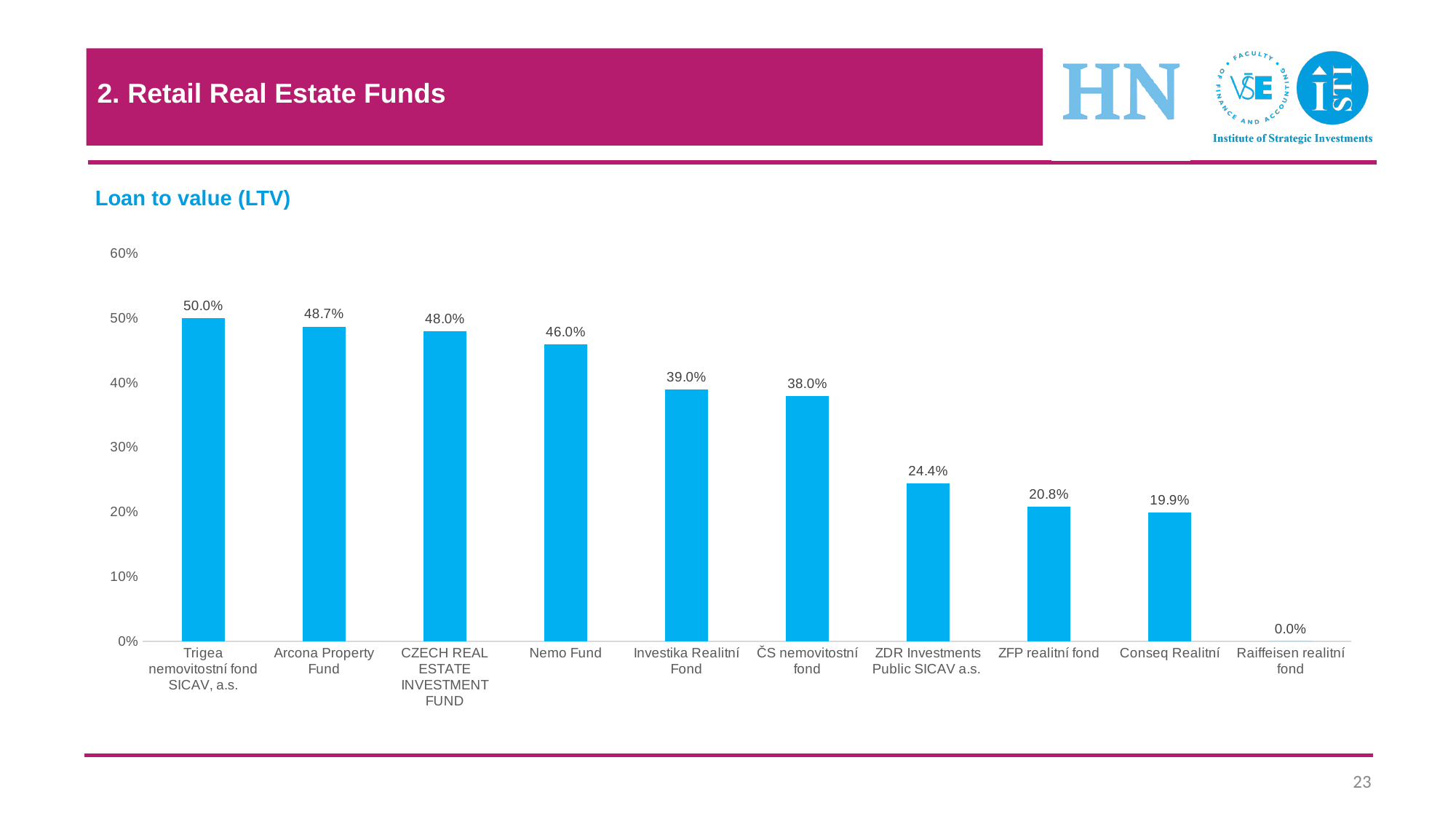
Which fund has the highest loan to value? Trigea nemovitostní fond SICAV, a.s. What type of chart is used to show loan to value? Bar chart What is the difference in LTV between Arcona Property Fund and CZECH REAL ESTATE INVESTMENT FUND? 0.7% Which has a higher LTV, ČS nemovitostní fond or ZDR Investments Public SICAV a.s.? ČS nemovitostní fond What is the difference in LTV between Investika Realitní Fond and ZFP realitní fond? 18.2% How many funds are shown in the chart? 10 What is the LTV for Conseq Realitní? 19.9% What is the LTV value shown for ZDR Investments Public SICAV a.s.? 24.4% What is the loan to value (LTV) for Nemo Fund? 46.0% Do the LTV values rise or fall from left to right across the chart? Fall Is the LTV for Investika Realitní Fond greater or less than 40%? less Which fund has the lowest loan to value? Raiffeisen realitní fond